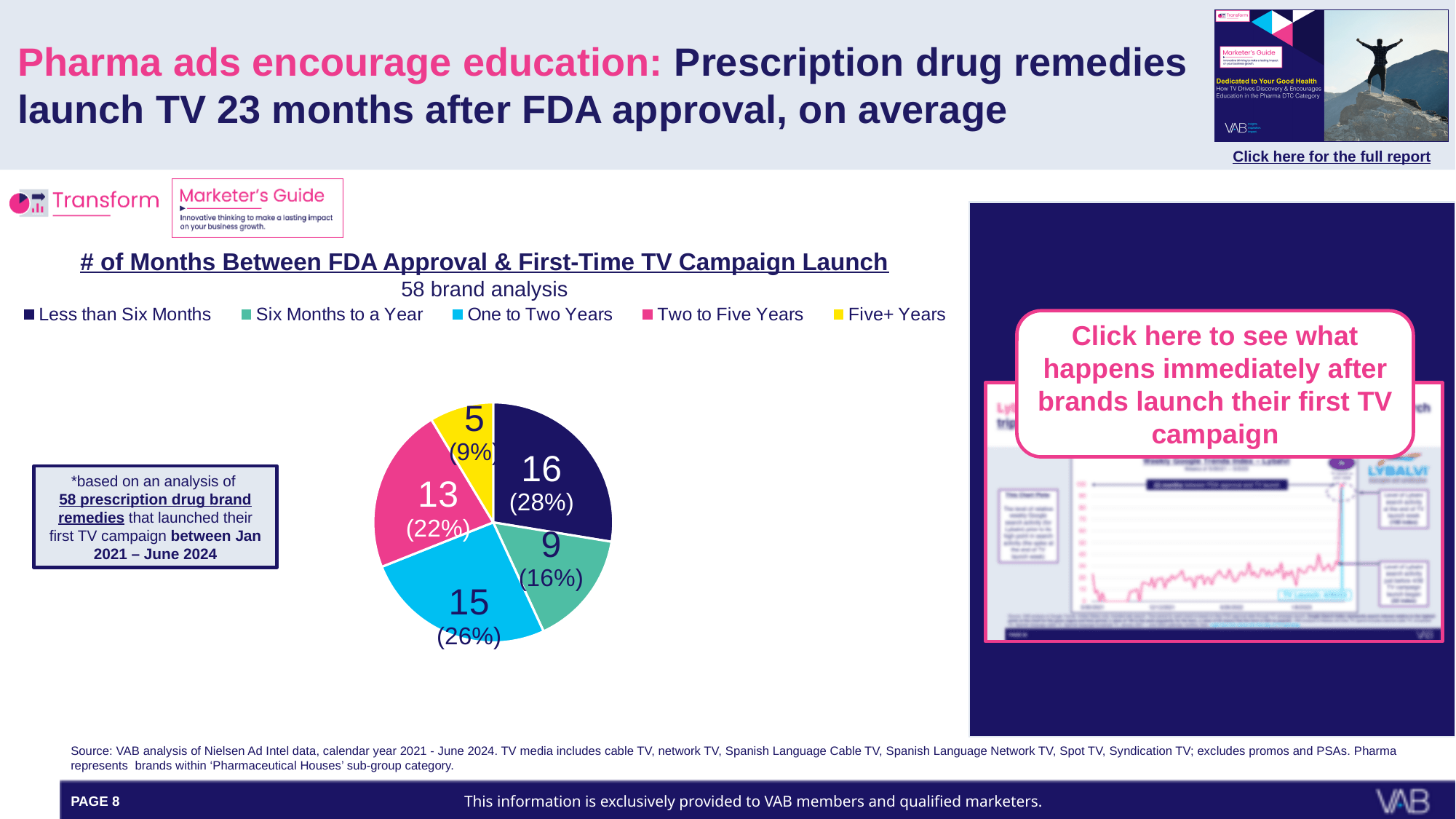
What is the title of the pie chart? # of Months Between FDA Approval & First-Time TV Campaign Launch What percentage of brands fall in the 'One to Two Years' category? 26% Which has more brands: 'One to Two Years' or 'Two to Five Years'? One to Two Years How many categories does the pie chart have? 5 Which category has the largest number of brands? Less than Six Months How many brands launched their first TV campaign less than six months after FDA approval? 16 What is the difference in brand count between 'Less than Six Months' and 'Six Months to a Year'? 7 How many brands were included in the analysis shown in the chart subtitle? 58 What share of the pie does the 'Five+ Years' slice represent? 9% How many brands are in the 'Two to Five Years' category? 13 What type of chart is shown on the slide? Pie chart Which category has the smallest number of brands? Five+ Years